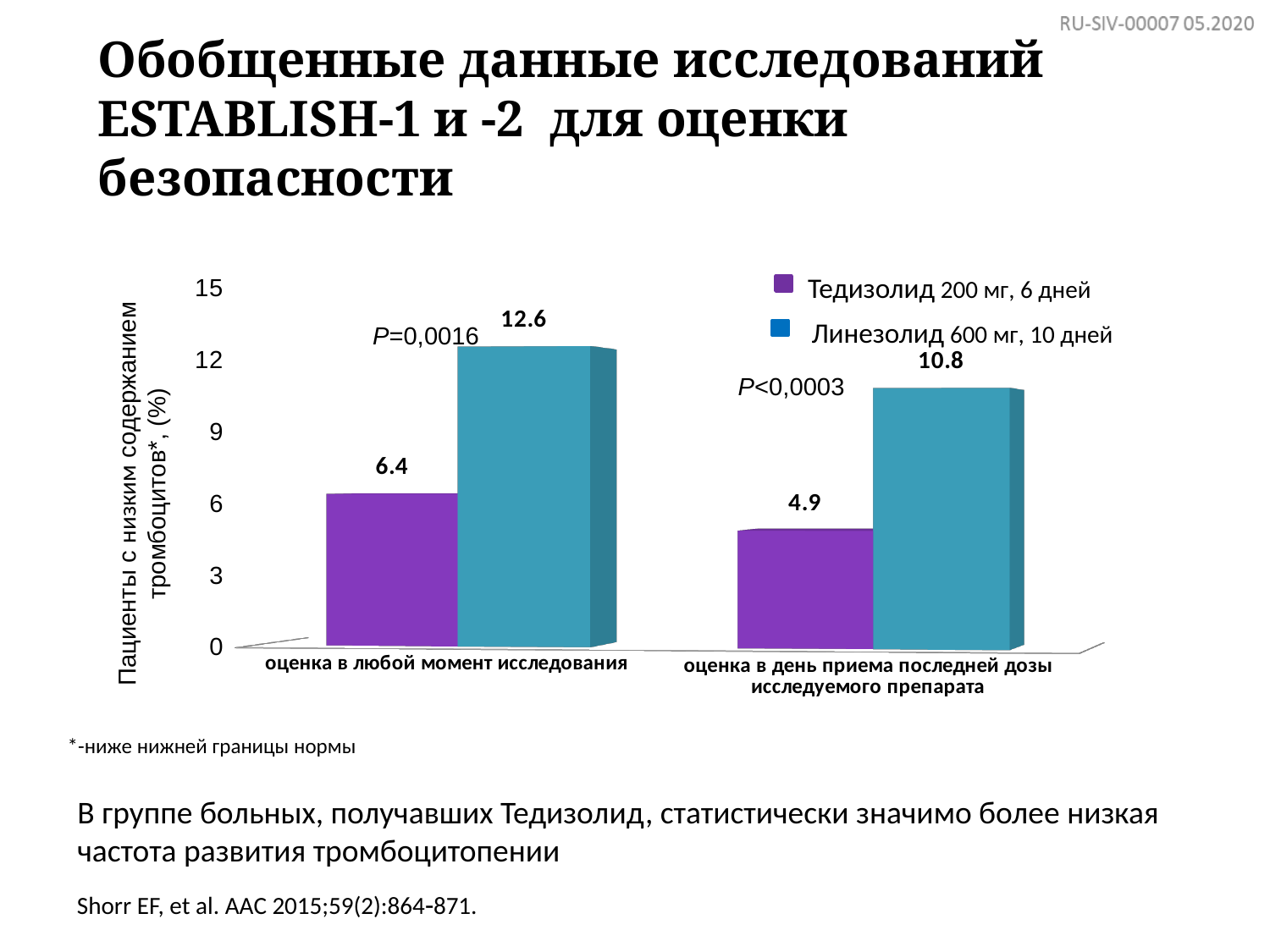
What kind of chart is shown on the slide? Bar chart How many series does the legend list? 2 Which is larger in the category "оценка в день приема последней дозы исследуемого препарата": the Тедизолид value or the Линезолид value? Линезолид 600 мг, 10 дней What is the difference between the Линезолид and Тедизолид values in the category "оценка в день приема последней дозы исследуемого препарата"? 5.9 Which bar has the lowest value on the chart? Тедизолид 200 мг, 6 дней, оценка в день приема последней дозы исследуемого препарата What is the difference between the Линезолид and Тедизолид values in the category "оценка в любой момент исследования"? 6.2 How many categories are shown on the x axis of the chart? 2 Which bar has the highest value on the chart? Линезолид 600 мг, 10 дней, оценка в любой момент исследования What is the value for Линезолид 600 мг, 10 дней in the category "оценка в день приема последней дозы исследуемого препарата"? 10.8 What is the value for Линезолид 600 мг, 10 дней in the category "оценка в любой момент исследования"? 12.6 What is the value for Тедизолид 200 мг, 6 дней in the category "оценка в любой момент исследования"? 6.4 What is the value for Тедизолид 200 мг, 6 дней in the category "оценка в день приема последней дозы исследуемого препарата"? 4.9